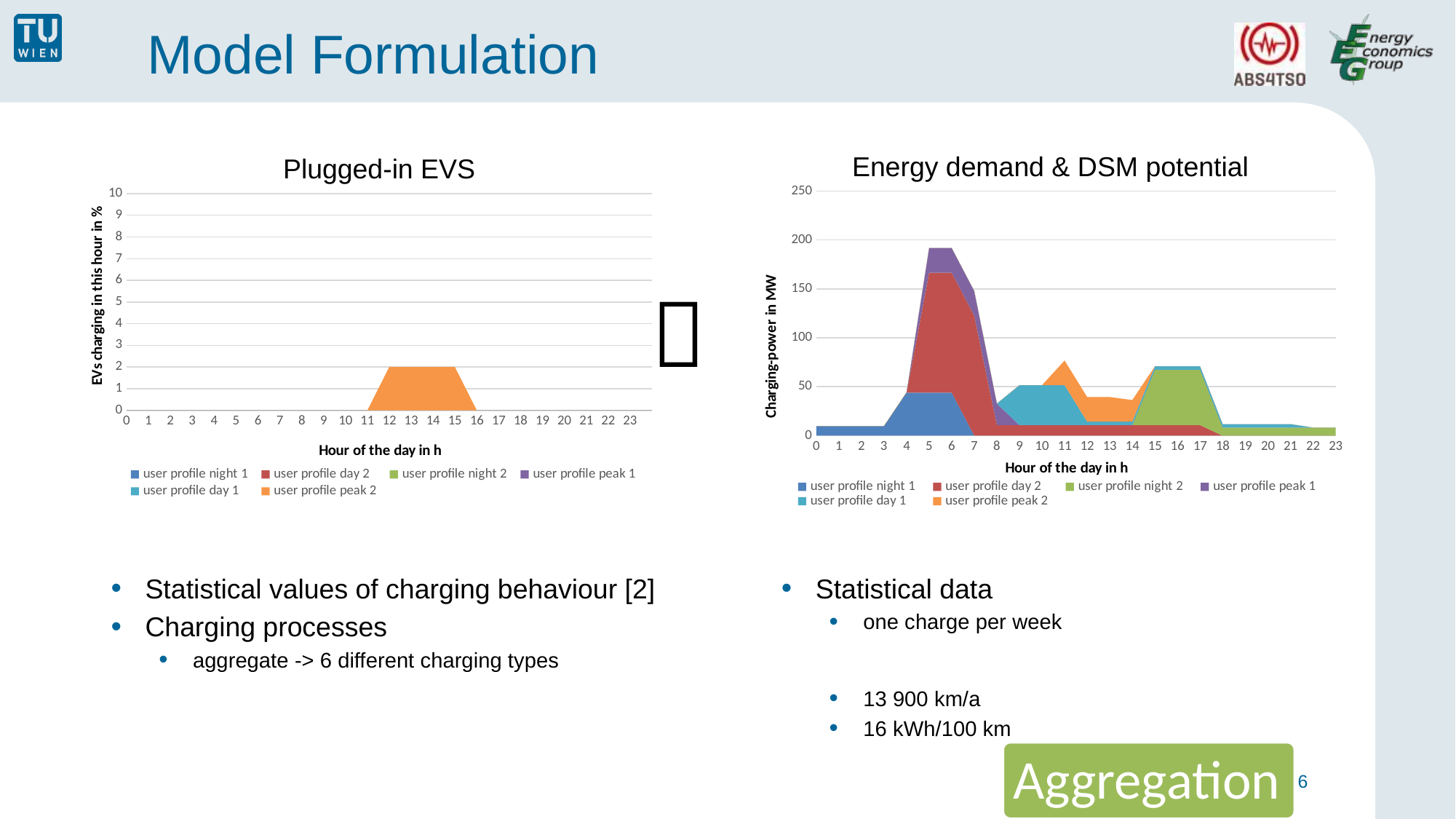
What kind of chart is the 'Plugged-in EVS' chart? area chart How many series does the legend of the 'Plugged-in EVS' chart list? 6 What is the y-axis title of the 'Energy demand & DSM potential' chart? Charging-power in MW In the 'Plugged-in EVS' chart, is the value for user profile peak 2 at hour 14 greater or less than 5? less In the 'Energy demand & DSM potential' chart, is the total charging power at hour 5 greater or less than 150? greater What kind of chart is the 'Energy demand & DSM potential' chart? area chart In the 'Energy demand & DSM potential' chart, is the total charging power at hour 10 greater or less than 100? less In the 'Energy demand & DSM potential' chart, is the total charging power higher at hour 5 or at hour 16? hour 5 In the 'Plugged-in EVS' chart, how many hours are shown on the x axis? 24 How many series does the legend of the 'Energy demand & DSM potential' chart list? 6 What is the y-axis title of the 'Plugged-in EVS' chart? EVs charging in this hour in % In the 'Plugged-in EVS' chart, what is the value for user profile peak 2 at hour 13? 2